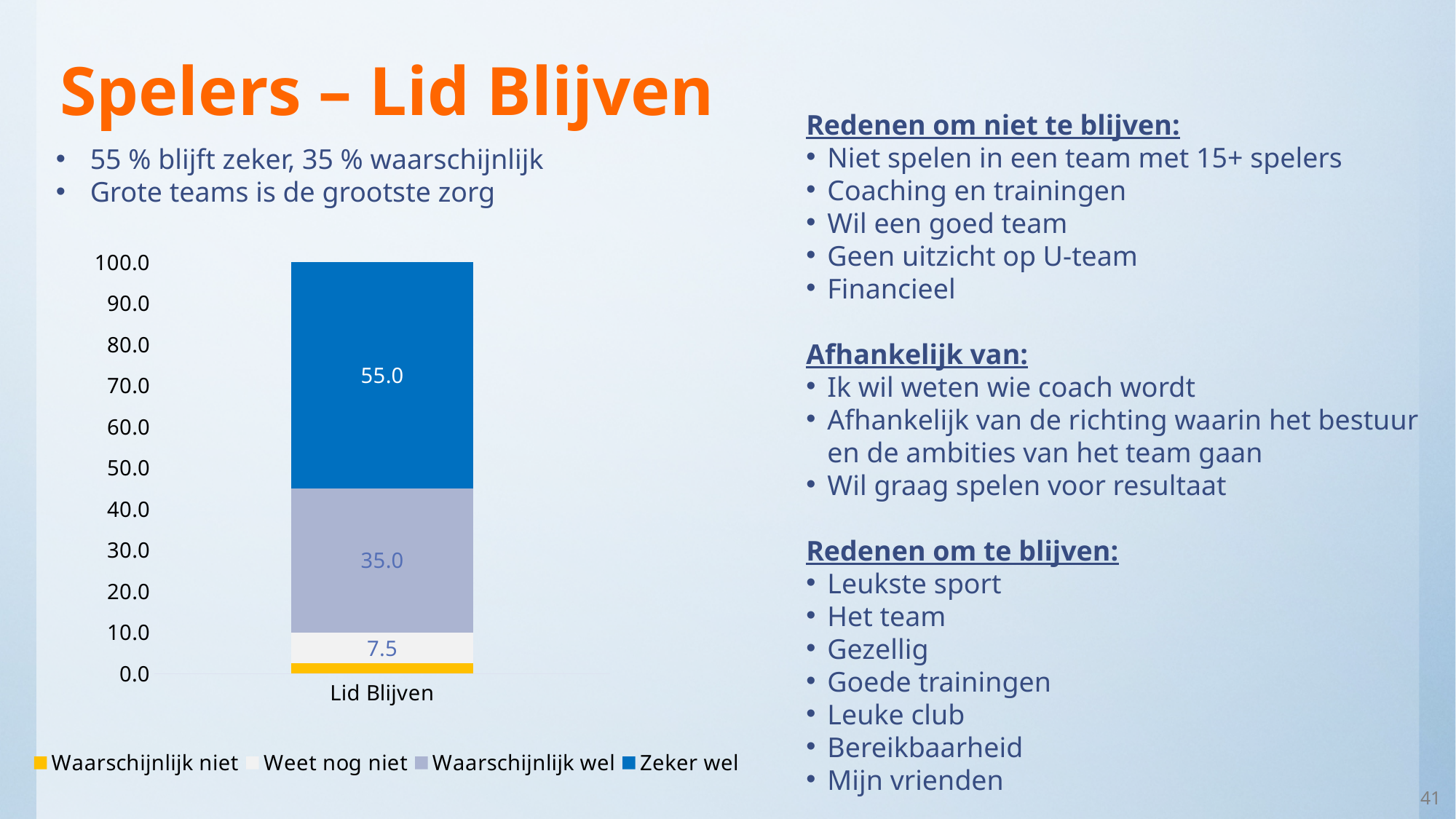
What is the difference between the Waarschijnlijk wel and Weet nog niet values? 27.5 How many categories are shown on the x axis of the chart? 1 What is the difference between the Zeker wel and Waarschijnlijk wel values? 20.0 What is the value of the Zeker wel segment in the Lid Blijven bar? 55.0 Which series has the largest segment in the Lid Blijven bar? Zeker wel Which series has the smallest segment in the Lid Blijven bar? Waarschijnlijk niet How many series does the chart legend list? 4 What kind of chart is shown on the slide? Stacked bar chart What is the value of the Weet nog niet segment in the Lid Blijven bar? 7.5 Which is larger, the Zeker wel segment or the Waarschijnlijk wel segment? Zeker wel What is the value of the Waarschijnlijk wel segment in the Lid Blijven bar? 35.0 Is the value for Waarschijnlijk niet greater or less than 10.0? less